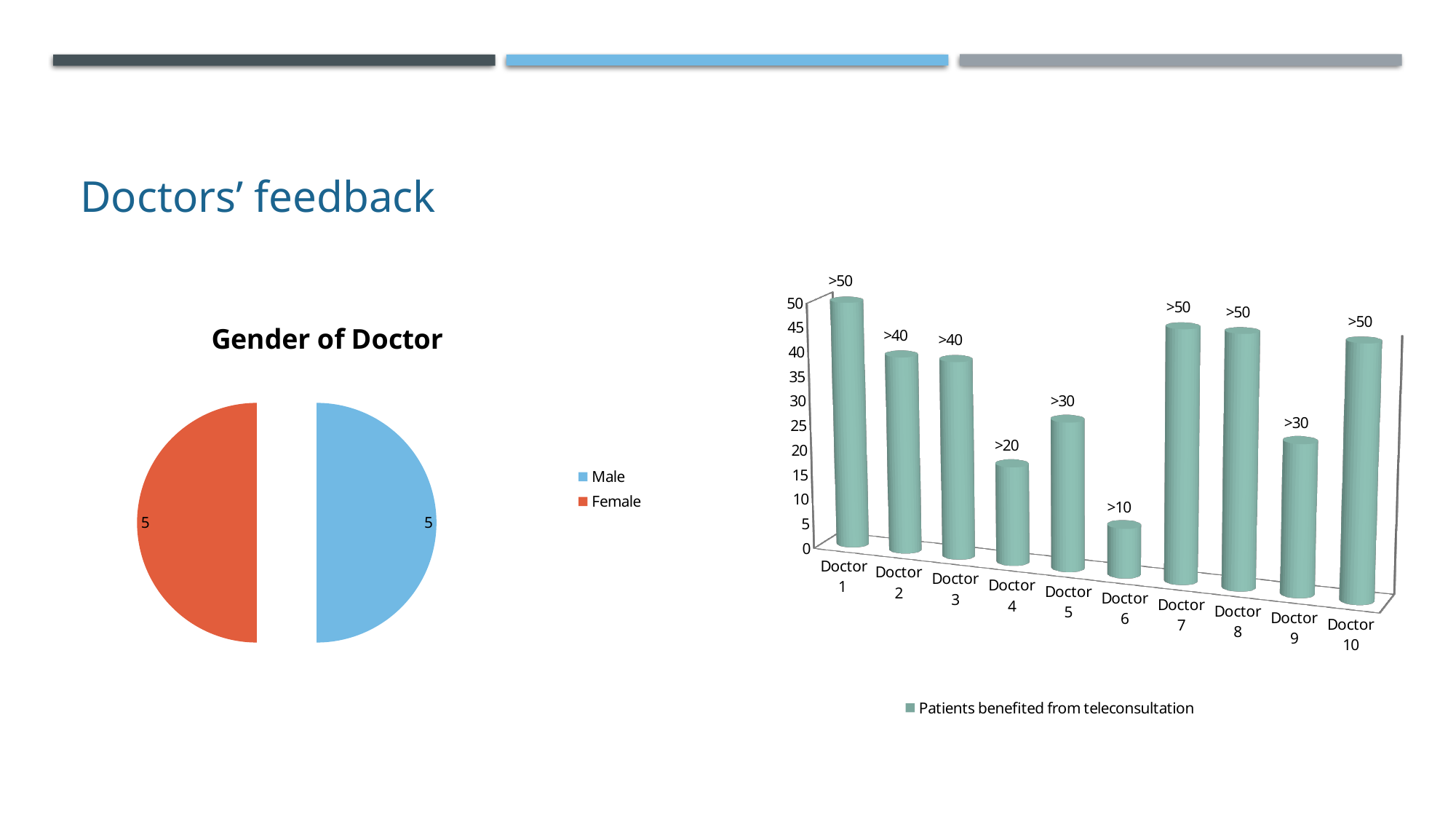
In the bar chart on the right, what is the data label for Doctor 1? >50 What kind of chart is the Gender of Doctor chart on the left? pie chart How many entries does the legend of the Gender of Doctor pie chart list? 2 In the bar chart on the right, what is the data label for Doctor 6? >10 In the Gender of Doctor pie chart, what is the value for Male? 5 What is the legend entry of the bar chart on the right? Patients benefited from teleconsultation In the Gender of Doctor pie chart, what is the value for Female? 5 In the bar chart on the right, which is larger, the value for Doctor 2 or the value for Doctor 5? Doctor 2 In the bar chart on the right, what is the data label for Doctor 4? >20 How many doctors are shown on the x axis of the bar chart on the right? 10 In the Gender of Doctor pie chart, what share of the pie does the Female slice represent? 50% In the bar chart on the right, which doctor has the lowest value? Doctor 6